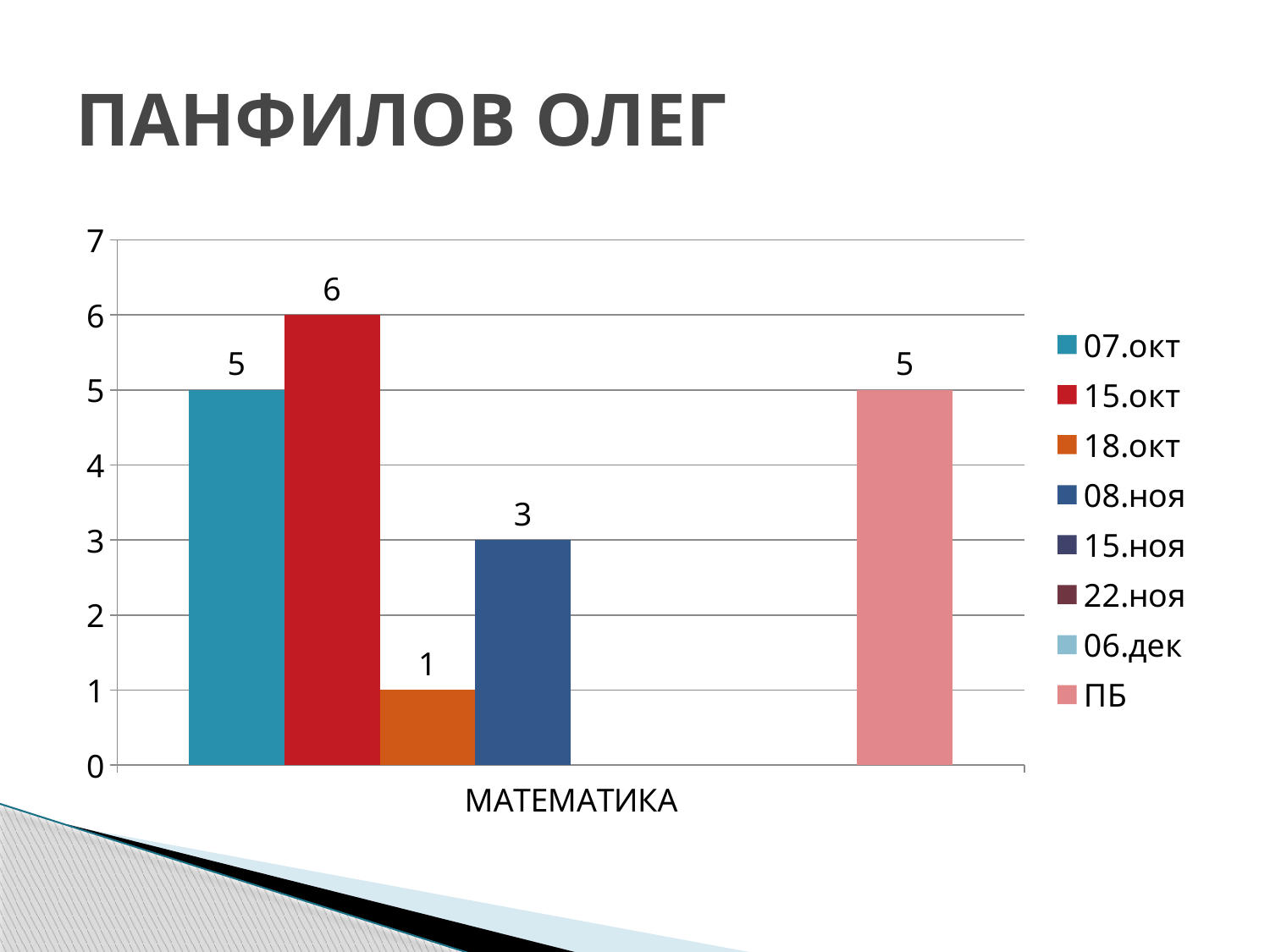
Which is larger, the value for 07.окт or the value for 08.ноя? 07.окт What is the value for the 15.окт series? 6 What kind of chart is shown on the slide? bar chart How many series does the legend list? 8 What is the difference between the 15.окт value and the 08.ноя value? 3 What is the value for the 08.ноя series? 3 What is the value for the 18.окт series? 1 Which series has the highest value in the chart? 15.окт What is the value for the ПБ series? 5 What is the category label shown on the x axis? МАТЕМАТИКА Which series has the lowest plotted value in the chart? 18.окт What is the value for the 07.окт series in the МАТЕМАТИКА category? 5